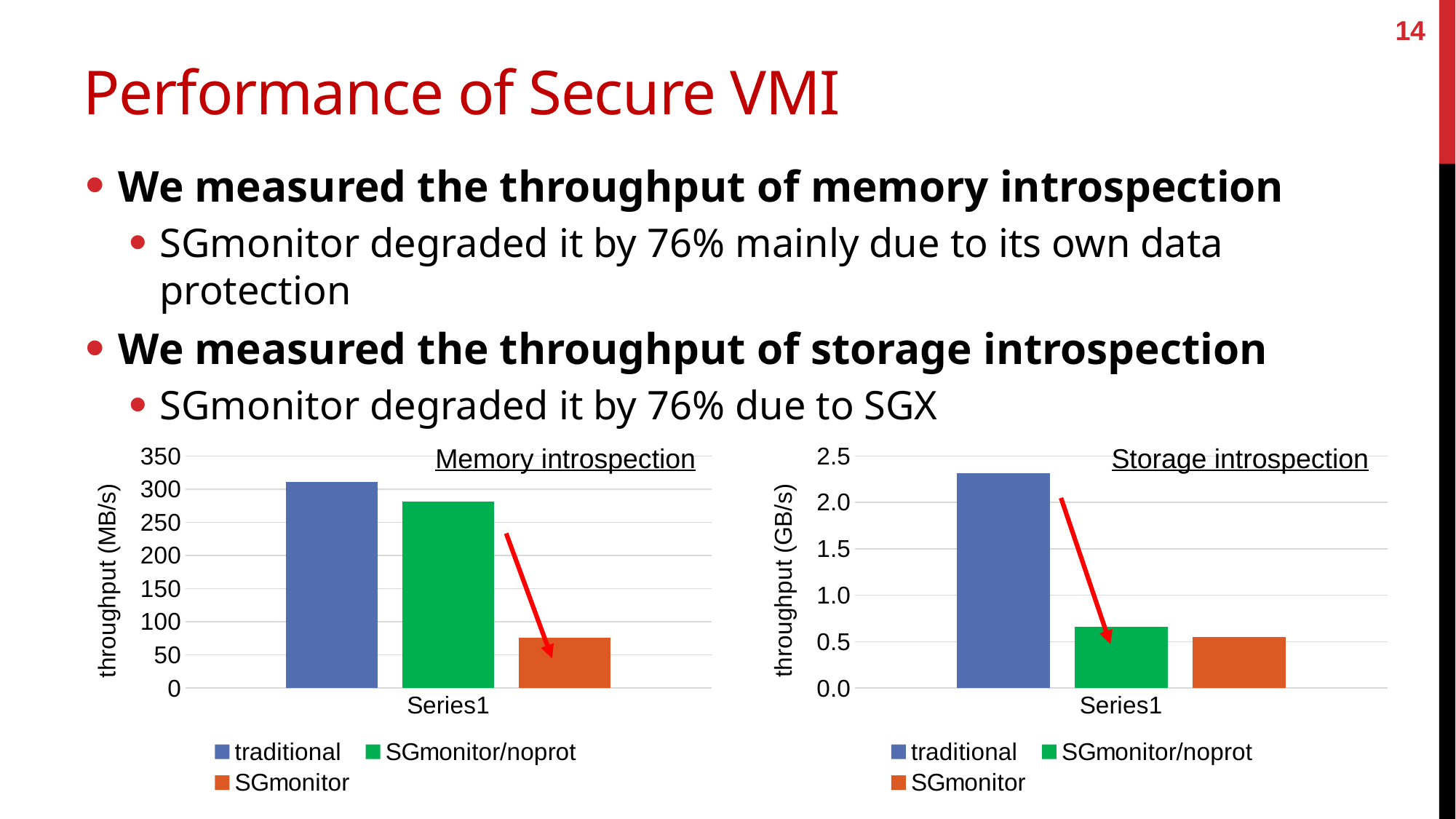
In the Memory introspection chart, is the value for SGmonitor greater or less than 100? less In the Memory introspection chart, what is the y-axis label? throughput (MB/s) In the Storage introspection chart, is the value for SGmonitor/noprot greater or less than 1.0? less In the Memory introspection chart, how many series does the legend list? 3 In the Memory introspection chart, is the value for traditional greater or less than 300? greater In the Storage introspection chart, which series has the highest throughput? traditional In the Memory introspection chart, which series has the highest throughput? traditional In the Memory introspection chart, which series has the lowest throughput? SGmonitor In the Storage introspection chart, what is the y-axis label? throughput (GB/s) In the Memory introspection chart, what kind of chart is shown? bar chart In the Memory introspection chart, which is larger, SGmonitor/noprot or SGmonitor? SGmonitor/noprot